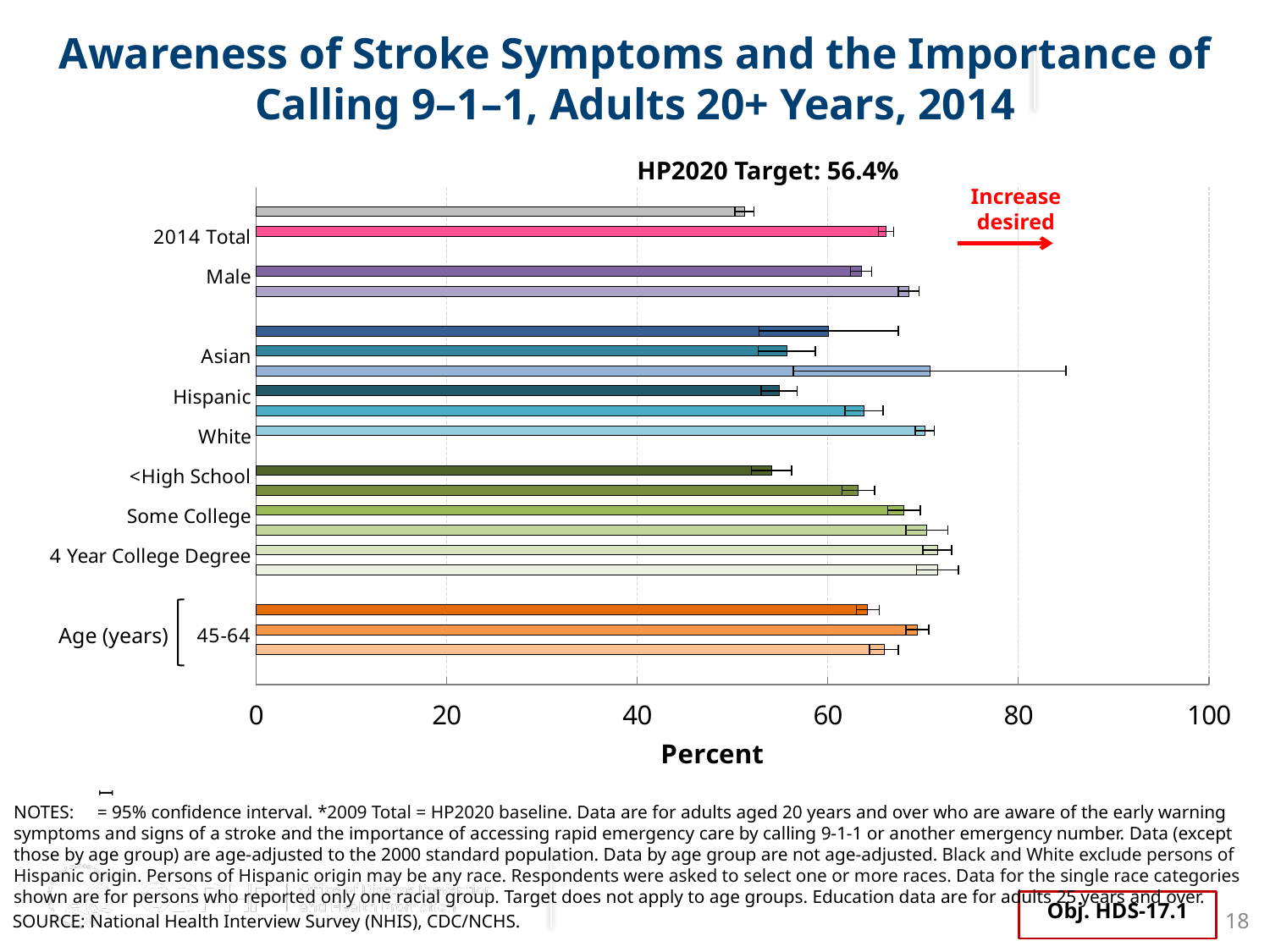
Is the value for Hispanic greater or less than 60? less Is the value for 4 Year College Degree greater or less than 60? greater What is the title of the horizontal axis? Percent What kind of chart is shown on the slide? bar chart Is the value for 2014 Total greater or less than 60? greater What is the HP2020 Target value shown on the chart? 56.4% Which has the larger value, White or Hispanic? White Which has the larger value, <High School or 4 Year College Degree? 4 Year College Degree